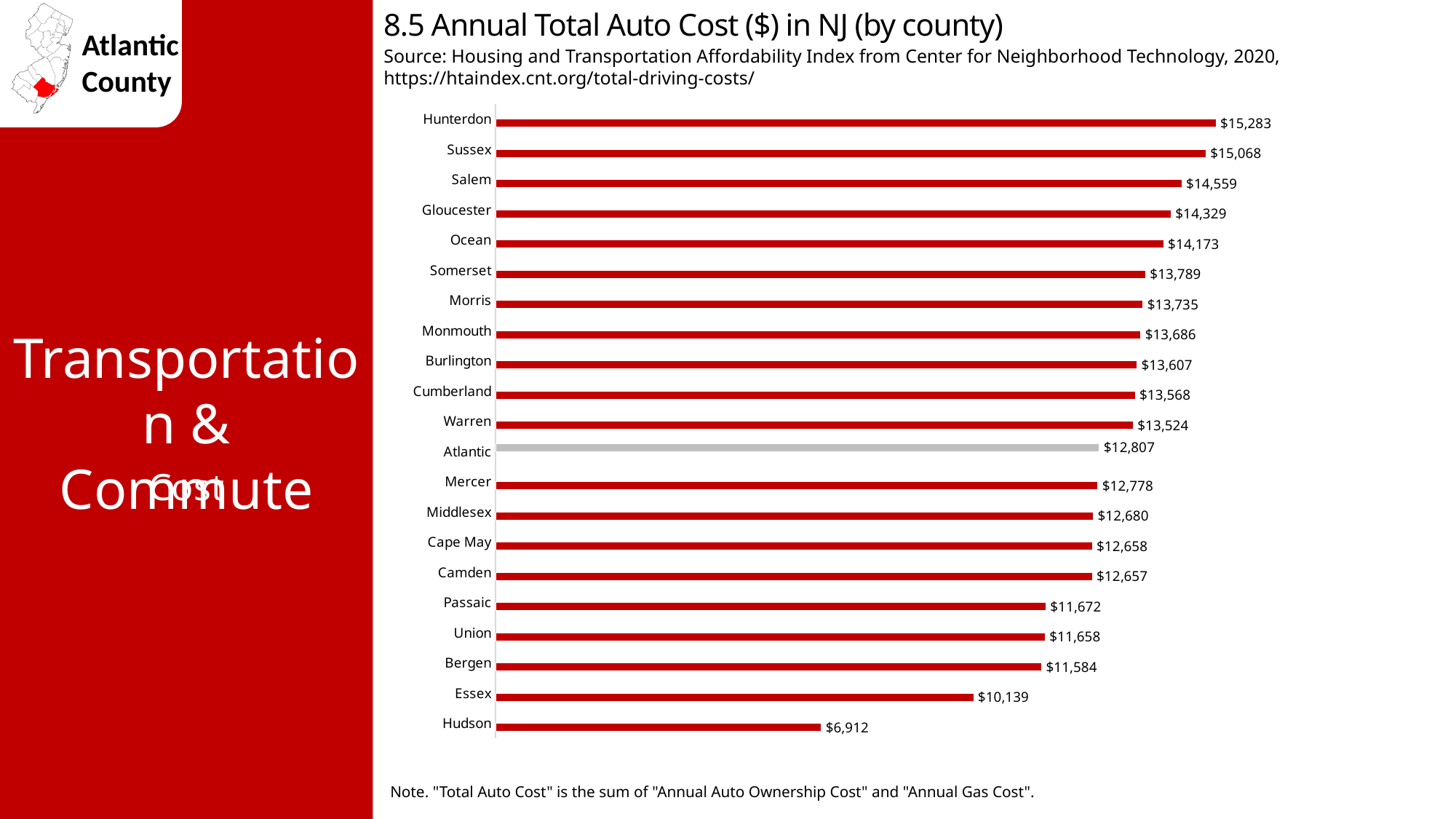
What is the annual total auto cost for Atlantic County? $12,807 Which county's bar is shown in gray instead of red? Atlantic What is the difference in annual total auto cost between Hunterdon and Hudson? $8,371 How many counties are shown in the chart? 21 Which county has a higher annual total auto cost, Bergen or Essex? Bergen Which county has the lowest annual total auto cost? Hudson What is the annual total auto cost for Gloucester County? $14,329 What type of chart is used to show annual total auto cost by county? Bar chart Which county has a higher annual total auto cost, Salem or Ocean? Salem What is the annual total auto cost for Hudson County? $6,912 What is the difference in annual total auto cost between Essex and Hudson? $3,227 Which county has the highest annual total auto cost? Hunterdon